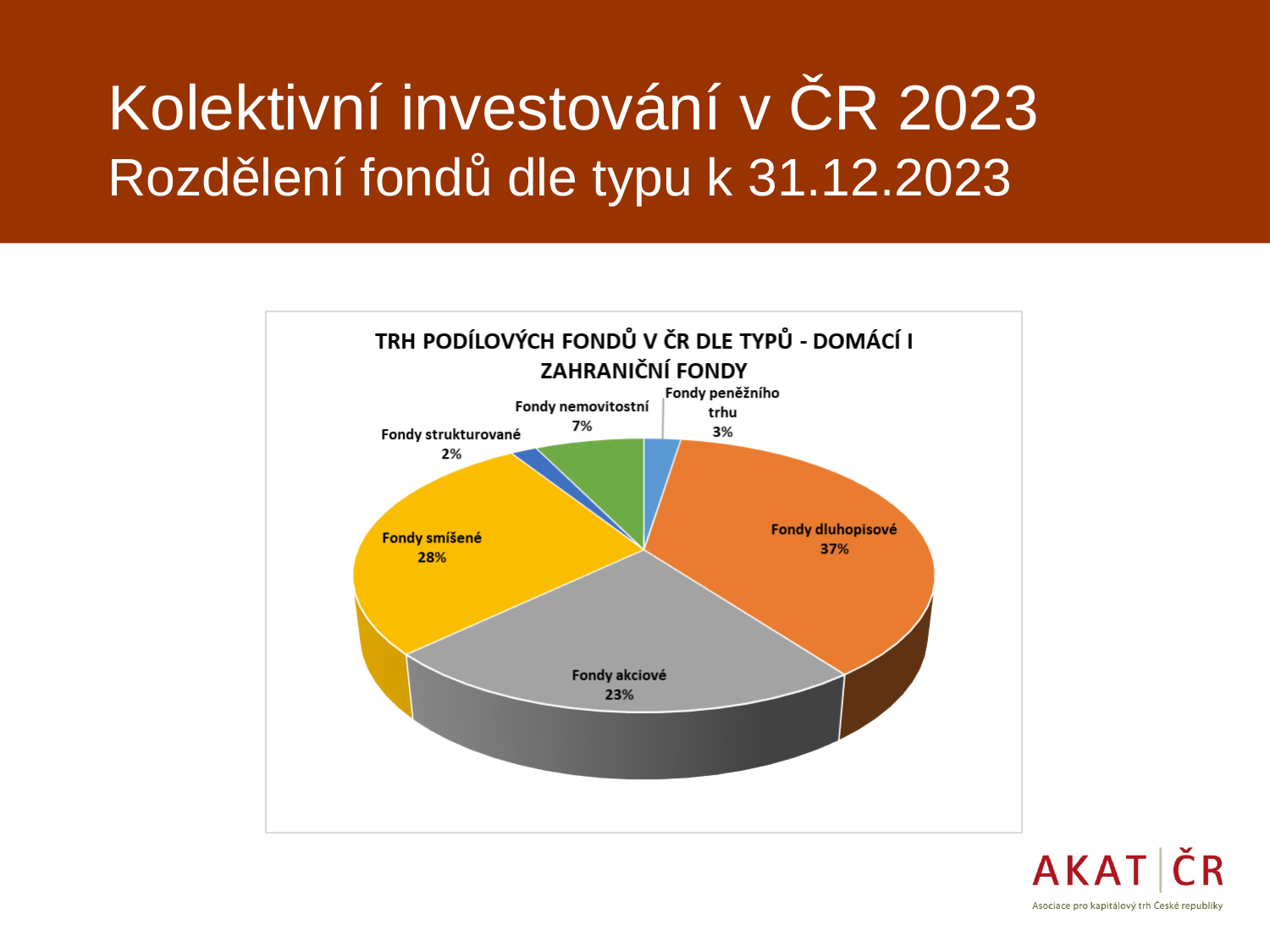
What is the value shown for Fondy smíšené? 28% What percentage is shown for Fondy akciové? 23% How many fund types are shown in the pie chart? 6 What is the difference in percentage points between Fondy dluhopisové and Fondy akciové? 14 Which fund type has the smallest slice of the pie? Fondy strukturované What is the value for Fondy peněžního trhu? 3% What share of the pie does Fondy dluhopisové hold? 37% Which is larger, the share for Fondy smíšené or the share for Fondy akciové? Fondy smíšené What kind of chart is shown on the slide? Pie chart What is the title of the chart? TRH PODÍLOVÝCH FONDŮ V ČR DLE TYPŮ - DOMÁCÍ I ZAHRANIČNÍ FONDY Which fund type has the largest slice of the pie? Fondy dluhopisové What share is shown for Fondy nemovitostní? 7%